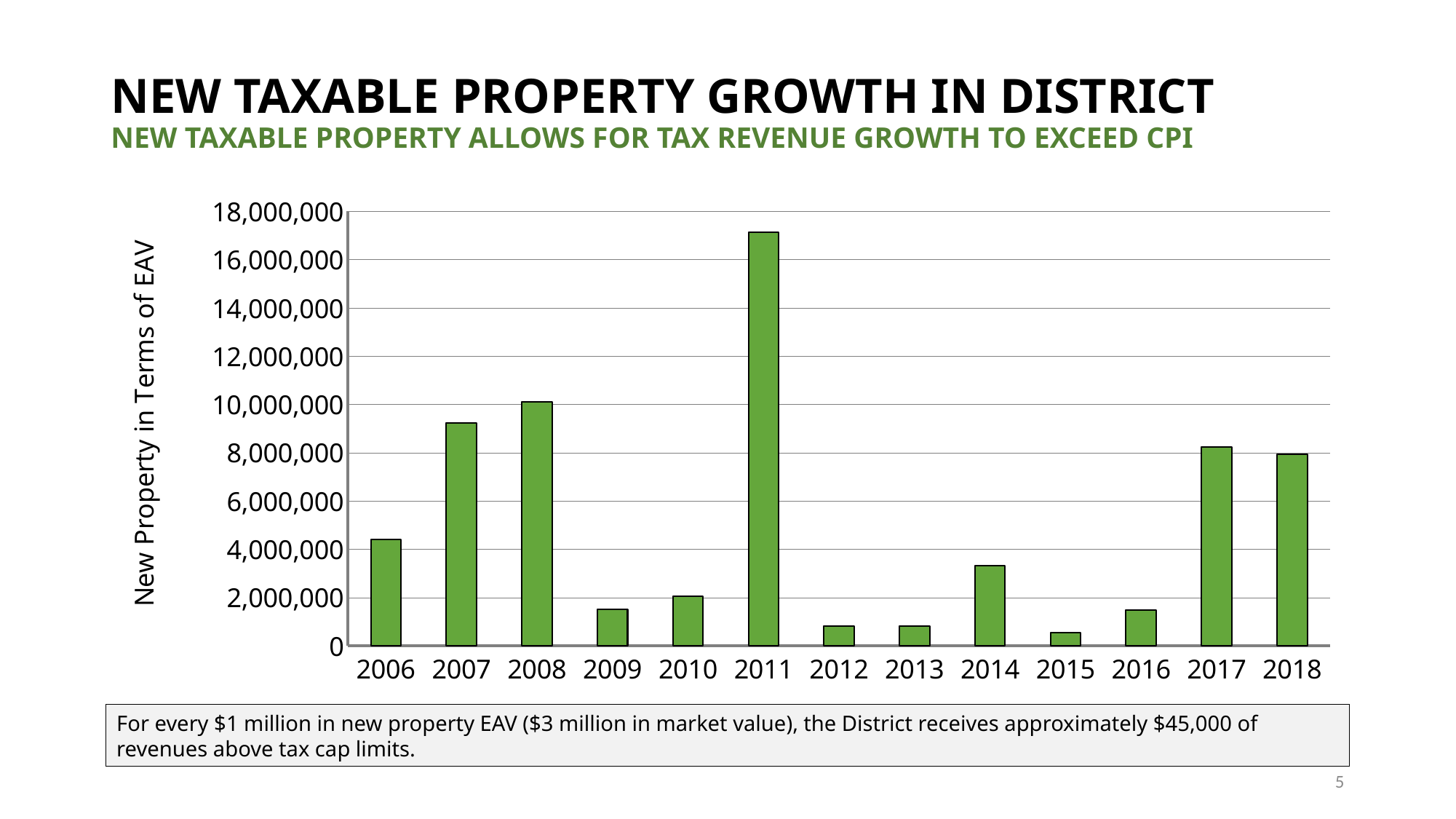
Is the value for 2014 greater or less than 4,000,000? less What kind of chart is shown on the slide? bar chart Is the value for 2011 greater or less than 16,000,000? greater Which year has the larger value, 2007 or 2008? 2008 Do the values rise or fall from 2011 to 2013? fall Is the value for 2009 greater or less than 2,000,000? less Which year has the larger value, 2006 or 2014? 2006 What is the title of the vertical axis of the chart? New Property in Terms of EAV How many years are plotted on the x axis of the chart? 13 Which year has the lowest new property EAV in the chart? 2015 Which year has the highest new property EAV in the chart? 2011